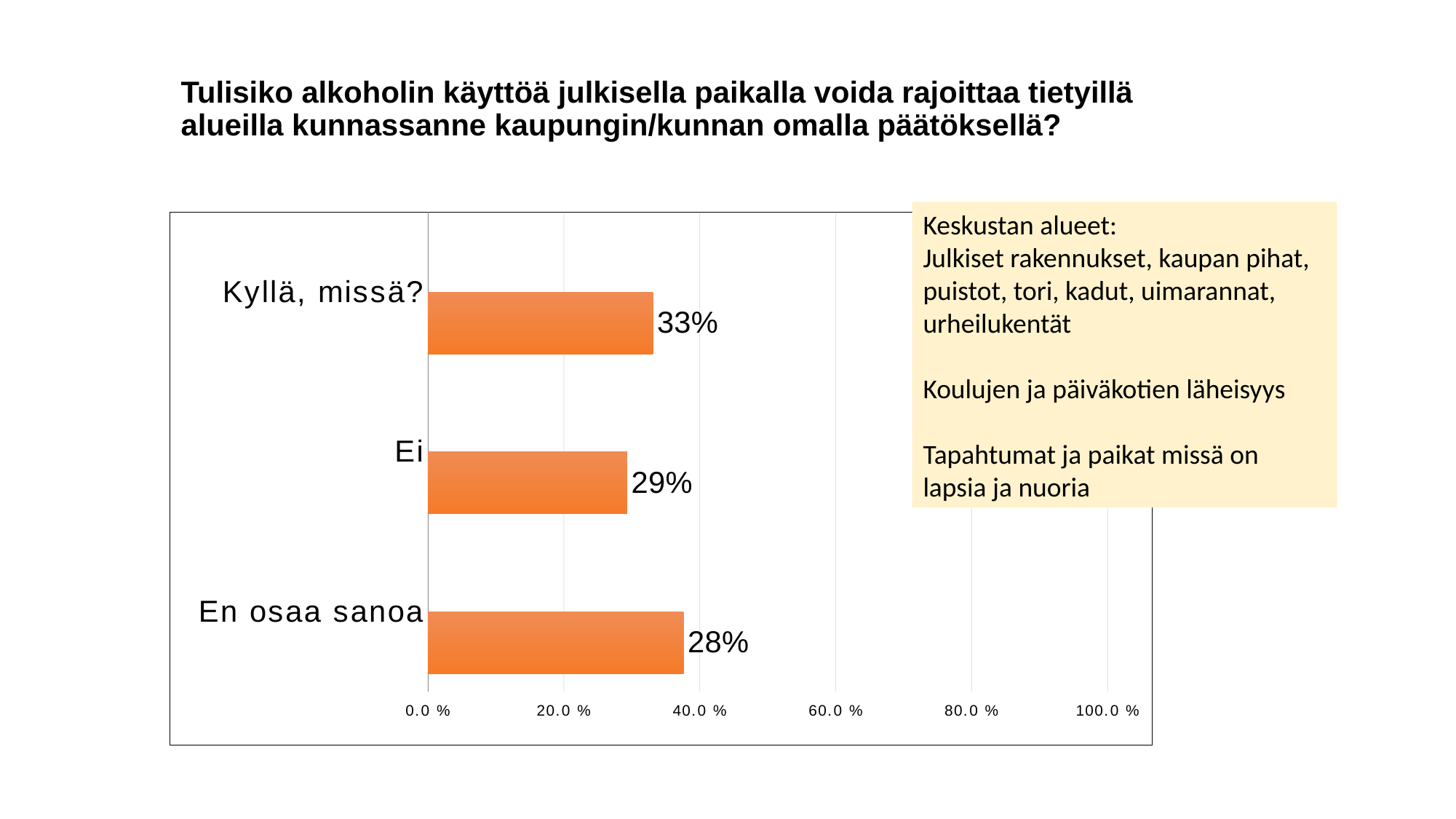
What is the value for "Kyllä, missä?"? 33% What kind of chart is shown on the slide? Bar chart Is the value for "Ei" greater or less than 40.0 %? less Is the value for "En osaa sanoa" greater or less than 60.0 %? less What is the difference between the values for "Kyllä, missä?" and "En osaa sanoa"? 5 percentage points What is the value for "En osaa sanoa"? 28% How many categories are shown in the chart? 3 What is the value for "Ei"? 29% Is the value for "Kyllä, missä?" greater or less than 20.0 %? greater What is the highest value shown on the x axis of the chart? 100.0 % What is the difference between the values for "Ei" and "En osaa sanoa"? 1 percentage point What is the difference between the values for "Kyllä, missä?" and "Ei"? 4 percentage points